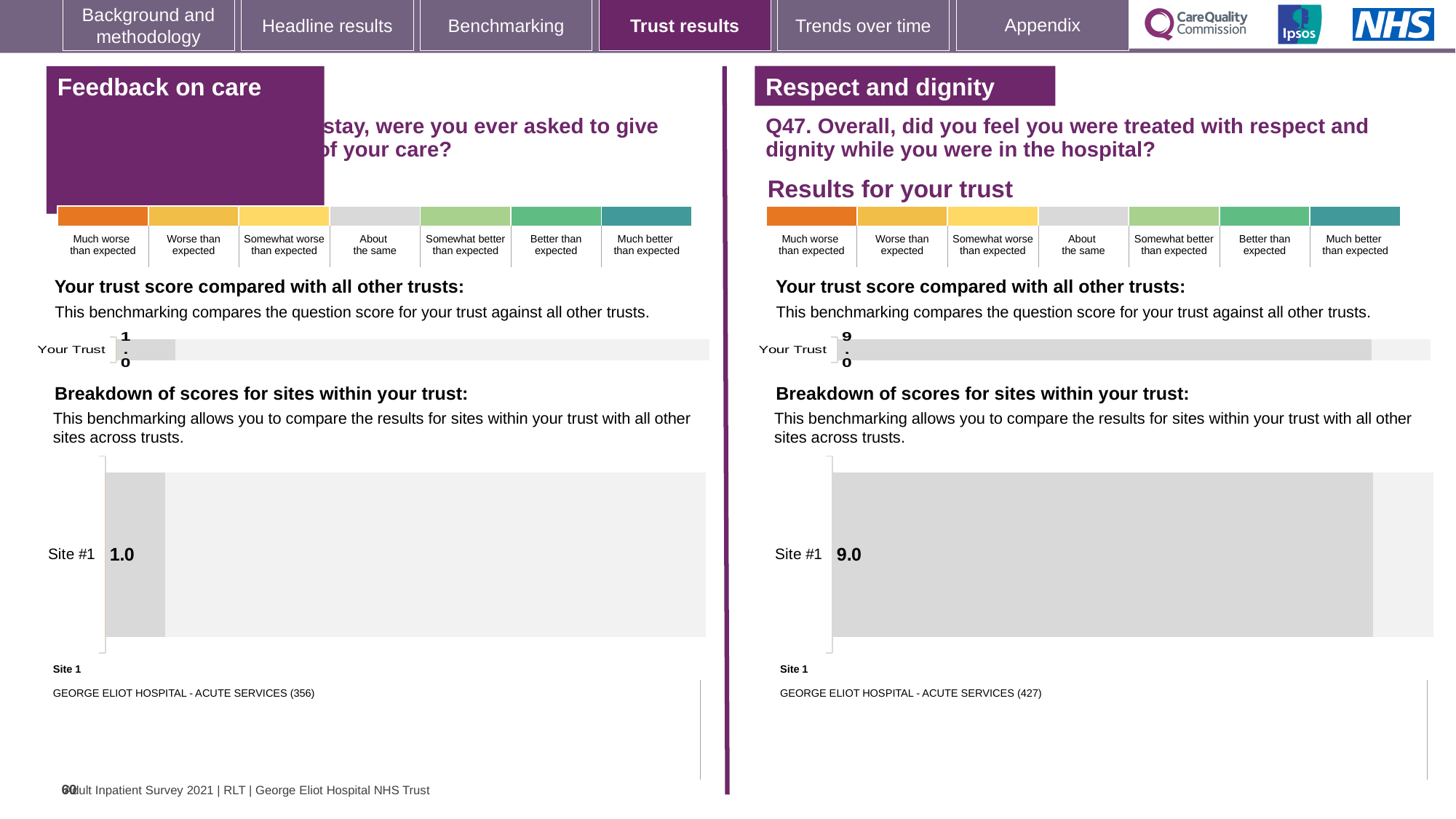
What kind of chart is used to show the Site #1 score in the Respect and dignity panel? Bar chart In the Respect and dignity panel, what score is shown for Site #1 in the 'Breakdown of scores for sites within your trust' chart? 9.0 In the Respect and dignity panel, which site is listed as Site 1 below the breakdown chart? GEORGE ELIOT HOSPITAL - ACUTE SERVICES (427) How many sites are shown in the 'Breakdown of scores for sites within your trust' chart in the Feedback on care panel? 1 What kind of chart is used to show the Your Trust score in the Feedback on care panel? Bar chart In the Respect and dignity panel, what is the score shown for Your Trust in the 'Your trust score compared with all other trusts' chart? 9.0 In the Feedback on care panel, what is the score shown for Your Trust in the 'Your trust score compared with all other trusts' chart? 1.0 Which is larger: the Site #1 score in the Respect and dignity panel or the Site #1 score in the Feedback on care panel? Respect and dignity What is the difference between the Your Trust score in the Respect and dignity panel and the Your Trust score in the Feedback on care panel? 8.0 How many sites are shown in the 'Breakdown of scores for sites within your trust' chart in the Respect and dignity panel? 1 In the Feedback on care panel, which site is listed as Site 1 below the breakdown chart? GEORGE ELIOT HOSPITAL - ACUTE SERVICES (356) In the Feedback on care panel, what score is shown for Site #1 in the 'Breakdown of scores for sites within your trust' chart? 1.0